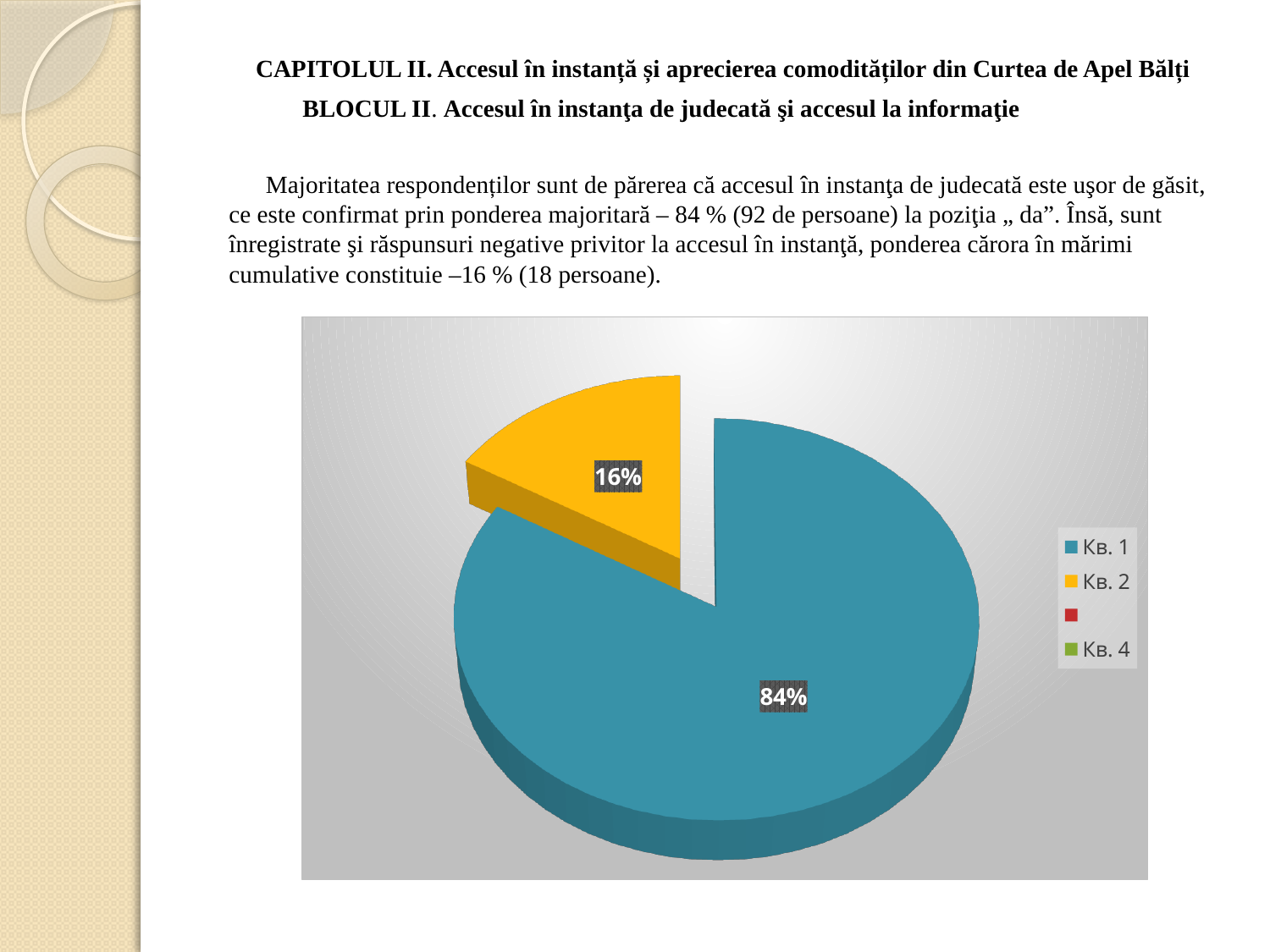
What share of the pie does the slice labelled Кв. 1 represent? 84% Which slice of the pie is the largest? Кв. 1 How many entries does the legend of the pie chart list? 4 What colour is the slice labelled 16% in the pie chart? yellow What kind of chart is shown on the slide? pie chart Which is larger, the Кв. 1 slice or the Кв. 2 slice? Кв. 1 Which slice of the pie is the smallest? Кв. 2 What is the difference in percentage points between the Кв. 1 slice and the Кв. 2 slice? 68 What share of the pie does the slice labelled Кв. 2 represent? 16% What colour is the slice labelled 84% in the pie chart? teal How many slices with data labels are visible in the pie chart? 2